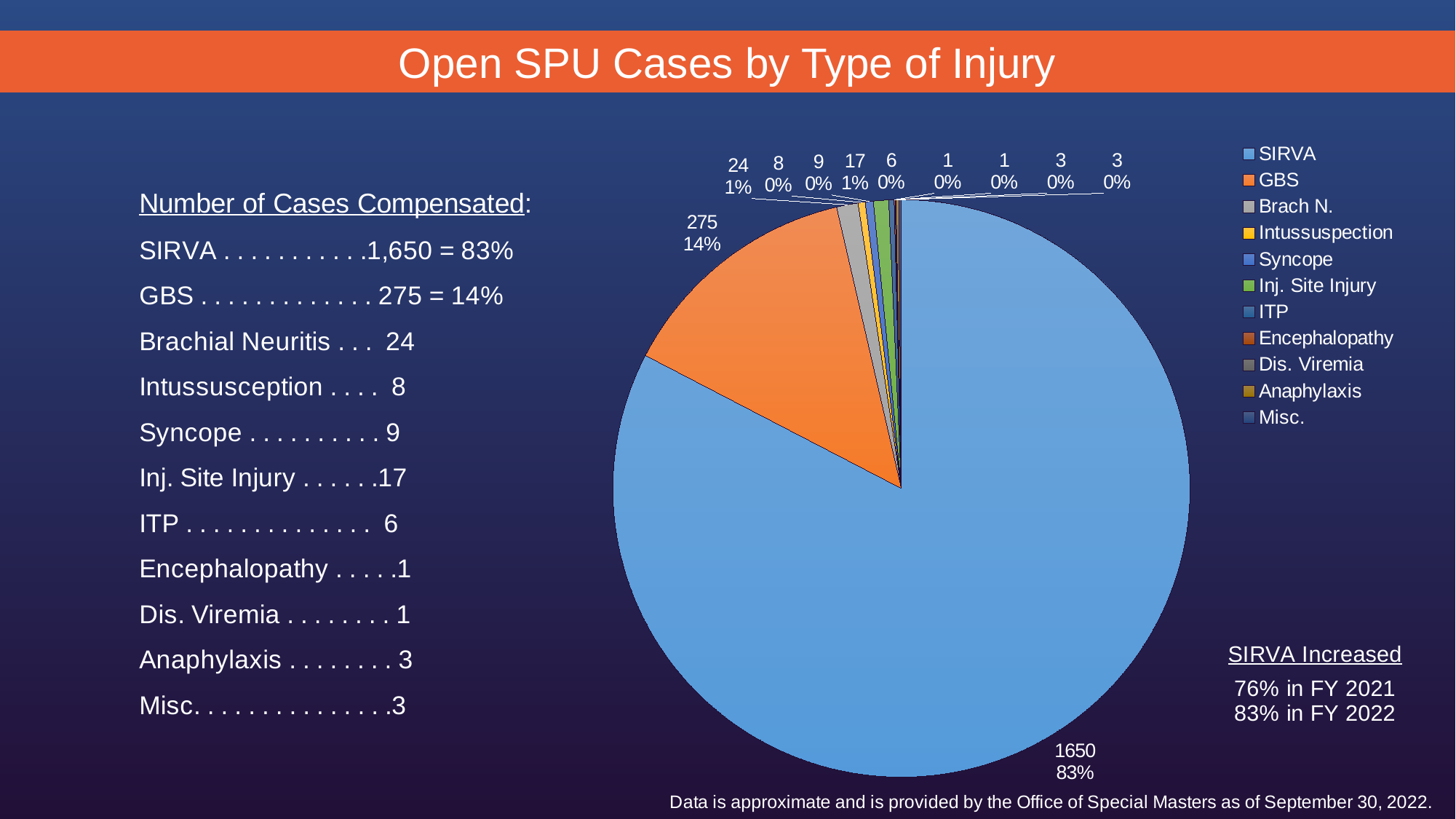
What is the value shown for Inj. Site Injury in the pie chart? 17 What is the difference between the SIRVA value and the GBS value in the pie chart? 1375 How many entries does the legend of the pie chart list? 11 What kind of chart is shown on the slide? pie chart What is the value shown for SIRVA in the pie chart? 1650 What is the value shown for GBS in the pie chart? 275 Which category has the largest slice of the pie chart? SIRVA Which is larger in the pie chart, the value for Brach N. or the value for Inj. Site Injury? Brach N. What is the title of the slide containing the pie chart? Open SPU Cases by Type of Injury What percentage share of the pie does GBS have? 14% What percentage share of the pie does SIRVA have? 83% What colour is the SIRVA slice in the pie chart? light blue